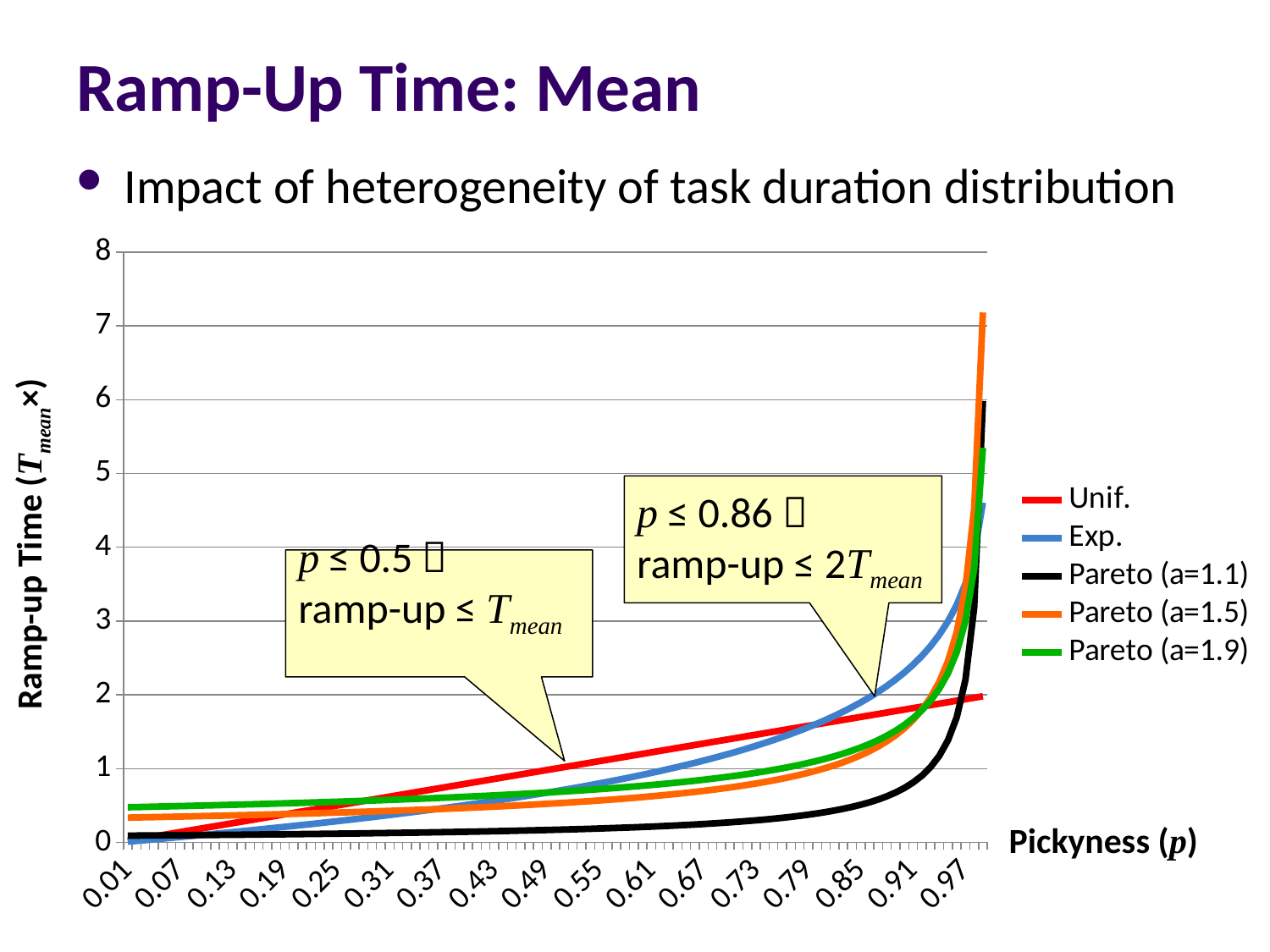
Which colour is used for the Unif. series in the legend? red Which series has the lowest ramp-up time at p = 0.73? Pareto (a=1.1) Does the Unif. series rise or fall as Pickyness (p) increases? rise Which series reaches the highest ramp-up time at the right end of the x axis? Pareto (a=1.5) Is the ramp-up time for Pareto (a=1.5) at p = 0.55 greater or less than 1? less What kind of chart is shown on the slide? line chart At p = 0.13, which series has the larger ramp-up time, Exp. or Pareto (a=1.9)? Pareto (a=1.9) Is the ramp-up time for Pareto (a=1.1) at p = 0.73 greater or less than 1? less How many series does the legend list? 5 Is the ramp-up time for Unif. at p = 0.85 greater or less than 2? less What is the label of the x axis? Pickyness (p) At p = 0.73, which series has the larger ramp-up time, Unif. or Pareto (a=1.1)? Unif.